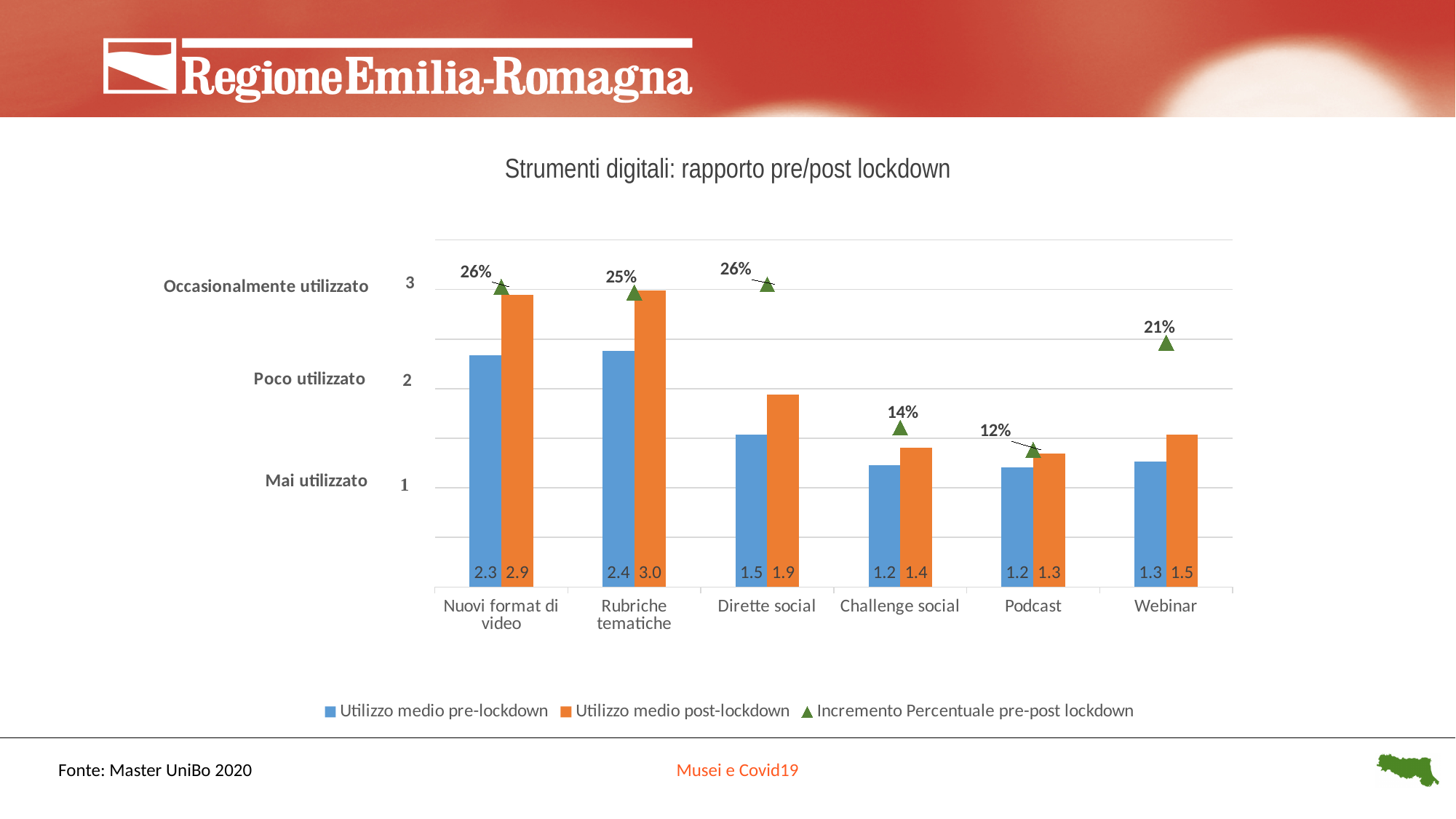
What is the percentage increase pre-post lockdown for Challenge social? 14% How many series does the legend list? 3 What is the average post-lockdown usage (Utilizzo medio post-lockdown) for Dirette social? 1.9 Which category has the lowest percentage increase pre-post lockdown? Podcast What is the difference between post-lockdown and pre-lockdown average usage for Rubriche tematiche? 0.6 What is the average pre-lockdown usage (Utilizzo medio pre-lockdown) for Nuovi format di video? 2.3 Which category has the highest average post-lockdown usage? Rubriche tematiche What is the percentage increase (Incremento Percentuale pre-post lockdown) shown for Webinar? 21% Which is larger: the post-lockdown usage for Challenge social or the post-lockdown usage for Webinar? Webinar What kind of chart is used to show the pre- and post-lockdown usage values? Bar chart How many digital tool categories are shown on the x axis? 6 What is the title of the chart? Strumenti digitali: rapporto pre/post lockdown